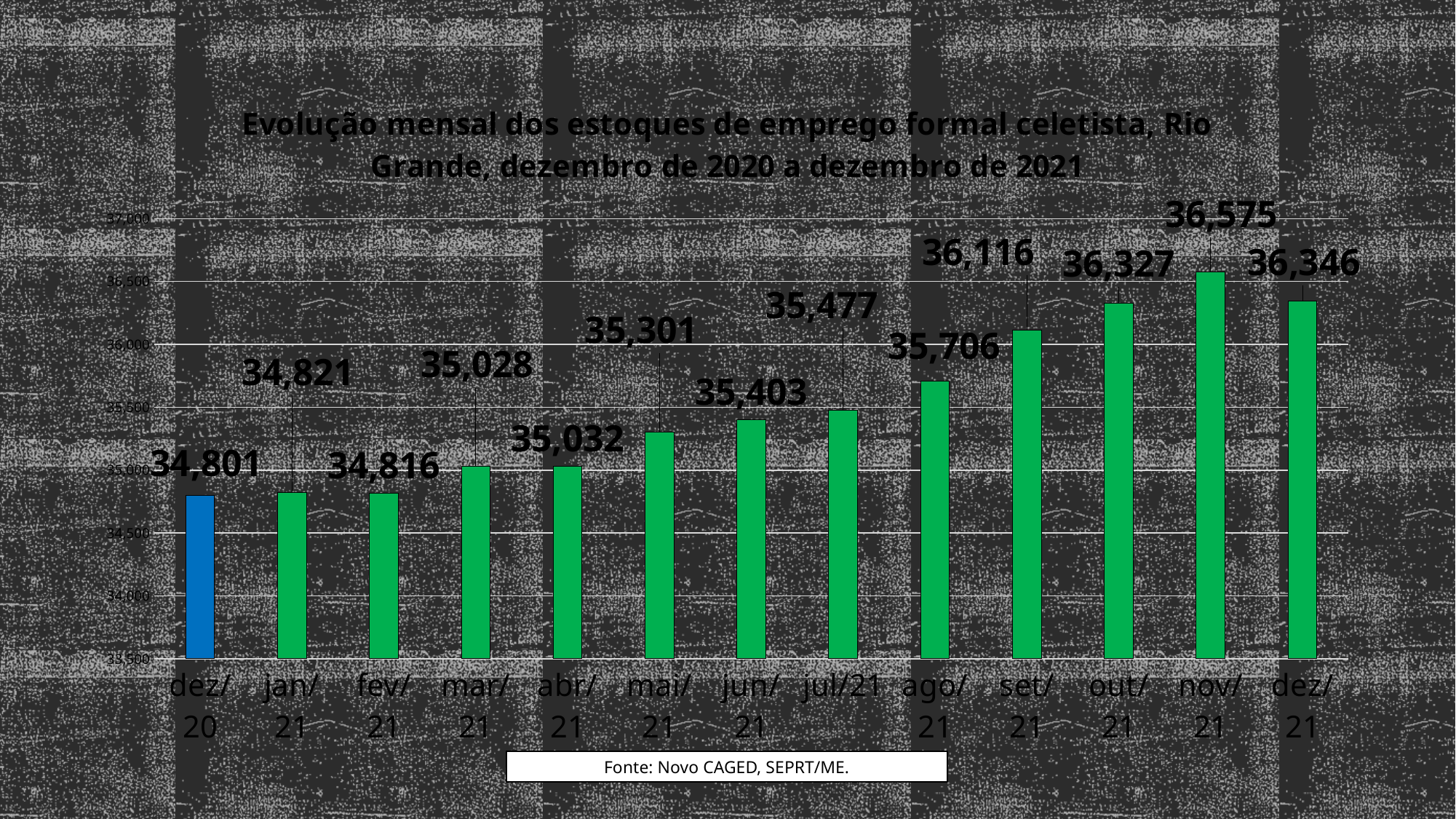
Which month has the highest value? nov/21 What is the value for ago/21? 35,706 What is the difference between the values for nov/21 and dez/20? 1,774 Which month has the lowest value? dez/20 How many months are shown on the x axis? 13 Do the values generally rise or fall from dez/20 to nov/21? rise Which is larger, the value for set/21 or the value for mai/21? set/21 What kind of chart is this? bar chart Is the value for ago/21 greater or less than 35,500? greater What is the value for dez/20? 34,801 What is the difference between the values for set/21 and ago/21? 410 What is the value for nov/21? 36,575